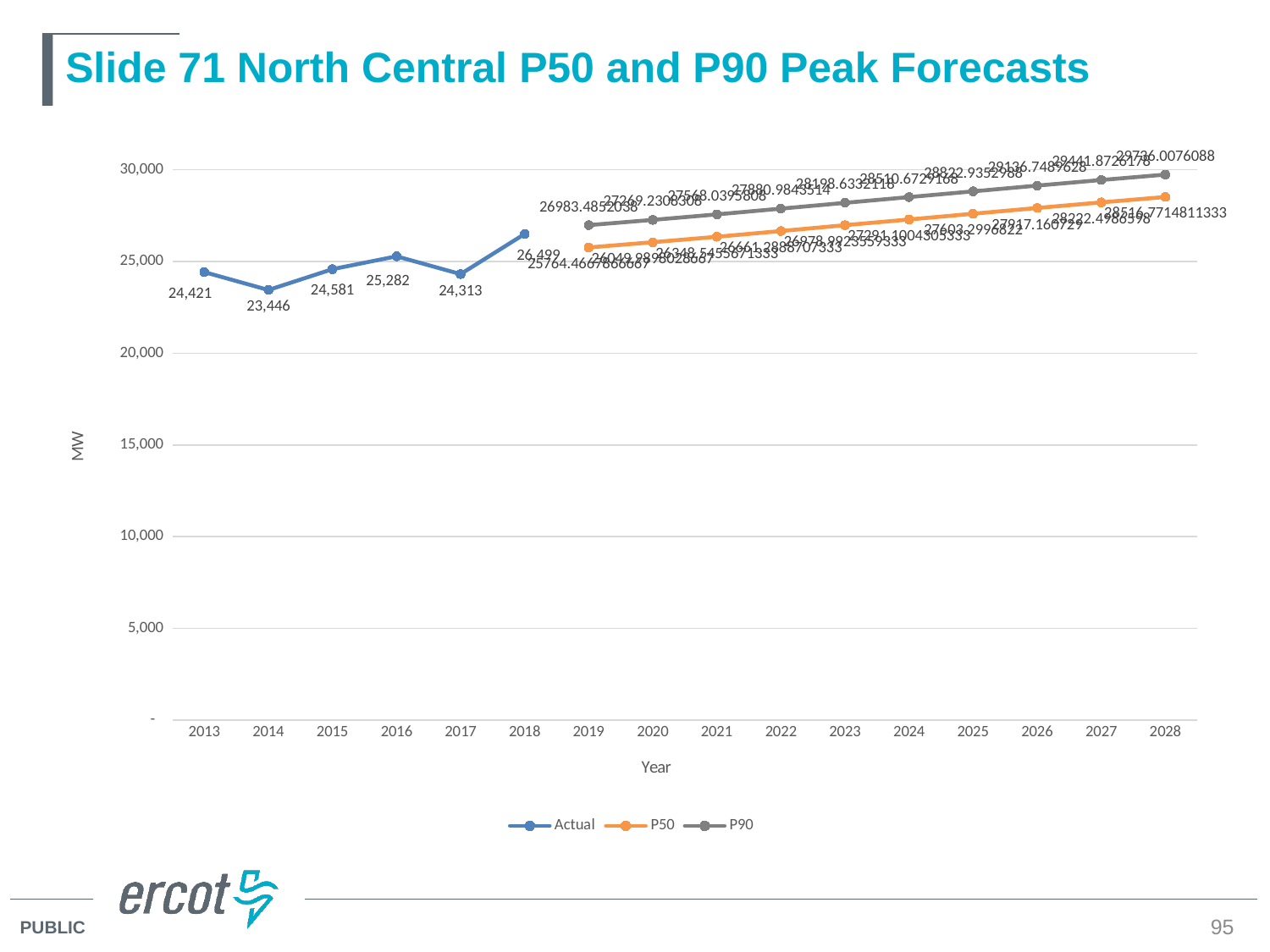
How many series does the legend list? 3 In 2024, which series has the larger value, P50 or P90? P90 Is the P90 value for 2028 greater or less than 25,000? greater What is the Actual value for 2014? 23,446 In which year is the Actual series lowest? 2014 What kind of chart is shown on the slide? line chart What is the difference between the Actual values for 2016 and 2015? 701 What is the Actual value for 2018? 26,499 In which year is the Actual series highest? 2018 What is the difference between the Actual values for 2018 and 2017? 2,186 Which year has the larger Actual value, 2013 or 2017? 2013 What is the Actual value for 2016? 25,282